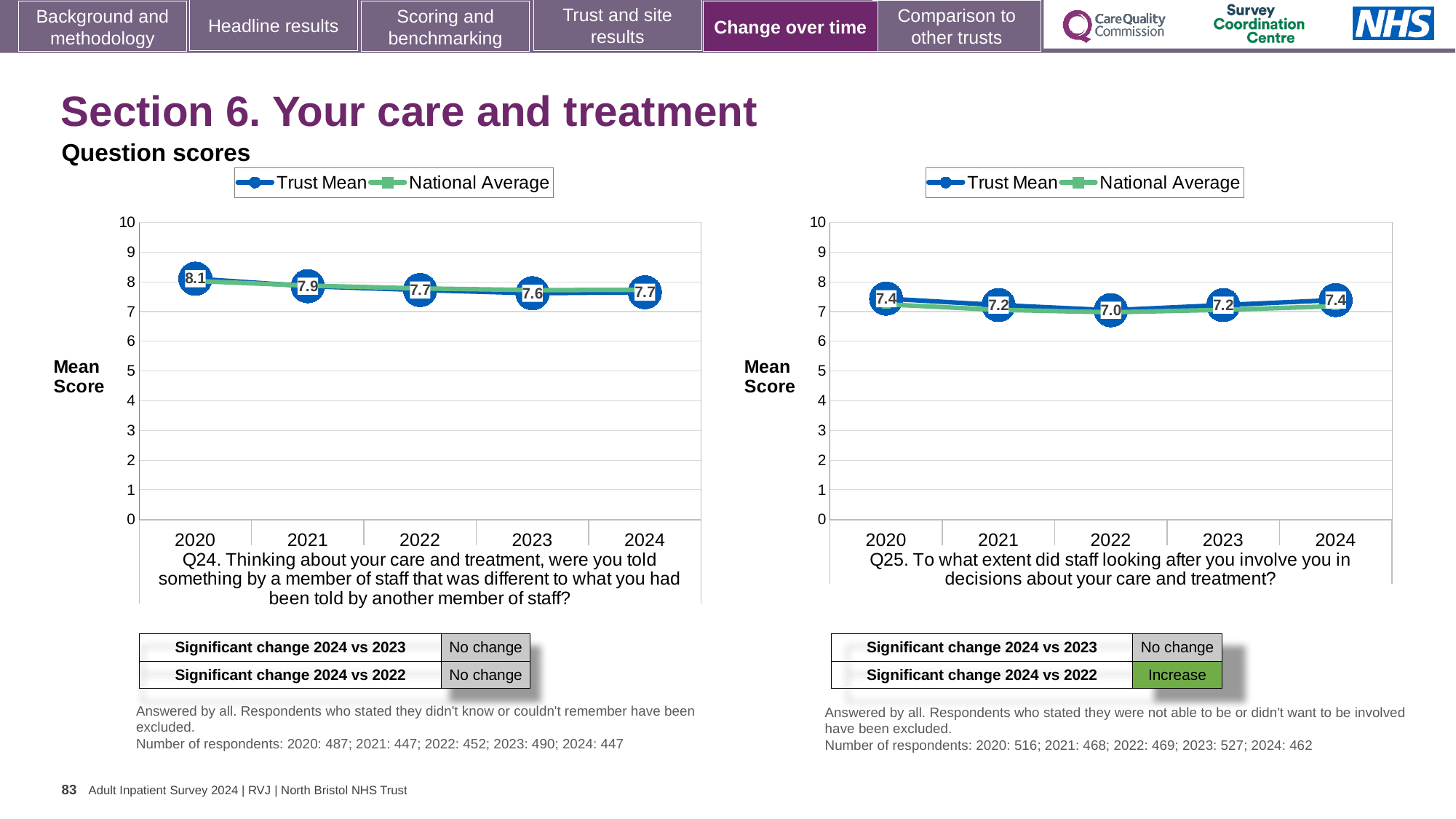
In the Q24 chart (left), is the Trust Mean value for 2022 greater or less than 8? less What kind of chart is the Q25 chart (right)? Line chart In the Q25 chart (right), what is the Trust Mean score for 2024? 7.4 How many years are plotted on the x axis of the Q25 chart (right)? 5 In the Q24 chart (left), which year has the highest Trust Mean score? 2020 In the Q24 chart (left), what is the Trust Mean score for 2023? 7.6 In the Q25 chart (right), what is the Trust Mean score for 2022? 7.0 In the Q24 chart (left), what is the difference between the Trust Mean scores for 2020 and 2024? 0.4 In the Q25 chart (right), which year has the lowest Trust Mean score? 2022 In the Q25 chart (right), is the Trust Mean score for 2020 larger or smaller than the score for 2021? larger In the Q24 chart (left), what is the Trust Mean score for 2020? 8.1 How many series does the legend of the Q24 chart (left) list? 2